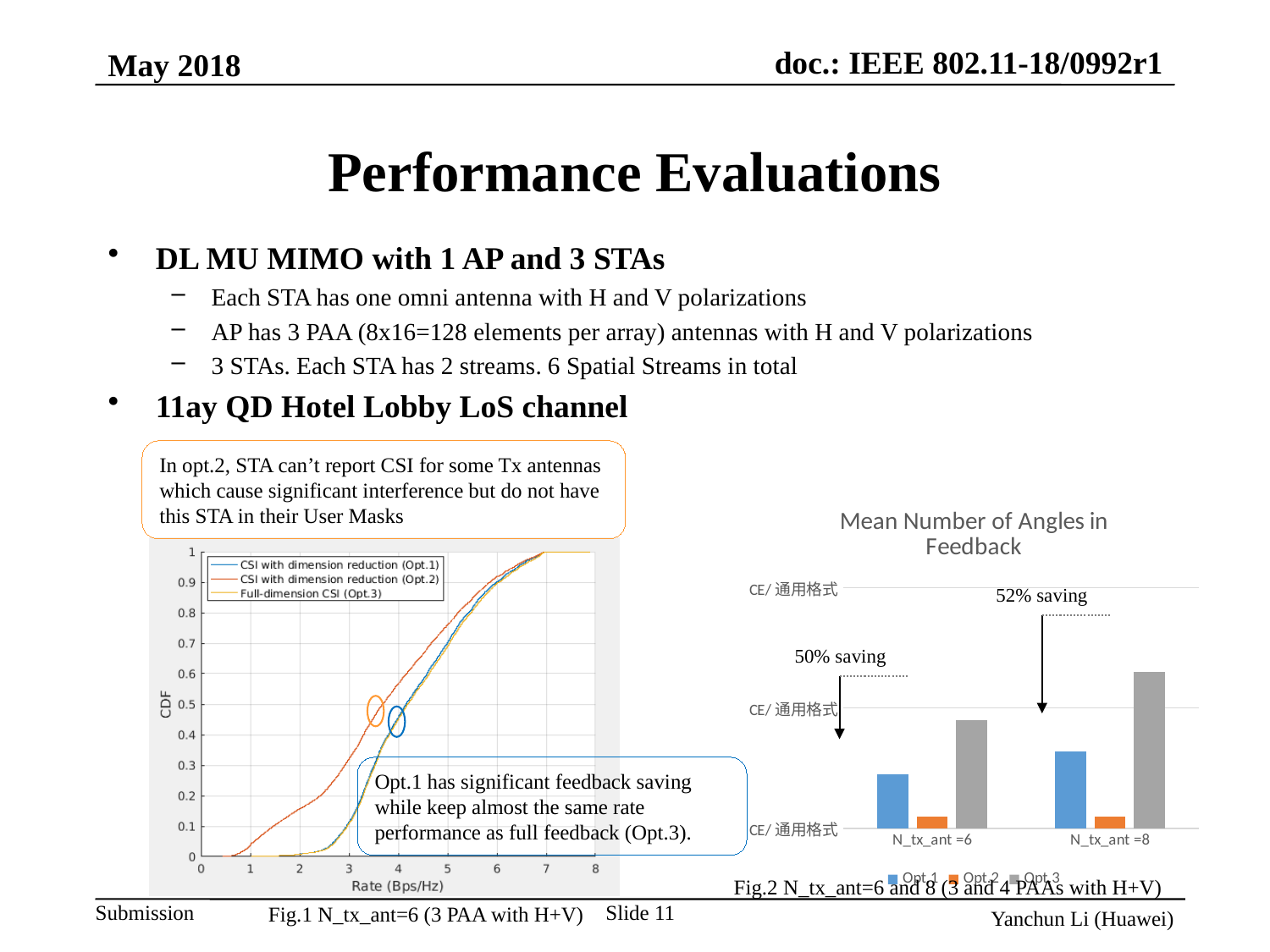
How many series does the legend of the 'Mean Number of Angles in Feedback' chart list? 3 How many categories are shown on the x axis of the 'Mean Number of Angles in Feedback' chart? 2 What is the x-axis label of the Fig.1 CDF chart? Rate (Bps/Hz) In the 'Mean Number of Angles in Feedback' chart, which series has the highest bar for N_tx_ant =6? Opt.3 In the 'Mean Number of Angles in Feedback' chart, do the Opt.3 bars rise or fall from N_tx_ant =6 to N_tx_ant =8? rise In the 'Mean Number of Angles in Feedback' chart, is the Opt.1 bar larger for N_tx_ant =6 or for N_tx_ant =8? N_tx_ant =8 In the Fig.1 CDF chart, is the CDF value of the Opt.2 curve at a rate of 2 Bps/Hz greater or less than 0.5? less What kind of chart is the 'Mean Number of Angles in Feedback' chart? bar chart What is the title of the bar chart on the right of the slide? Mean Number of Angles in Feedback In the 'Mean Number of Angles in Feedback' chart, which series has the lowest bar for N_tx_ant =8? Opt.2 How many series does the legend of the Fig.1 CDF chart list? 3 What kind of chart is Fig.1 (the CDF versus Rate chart)? line chart